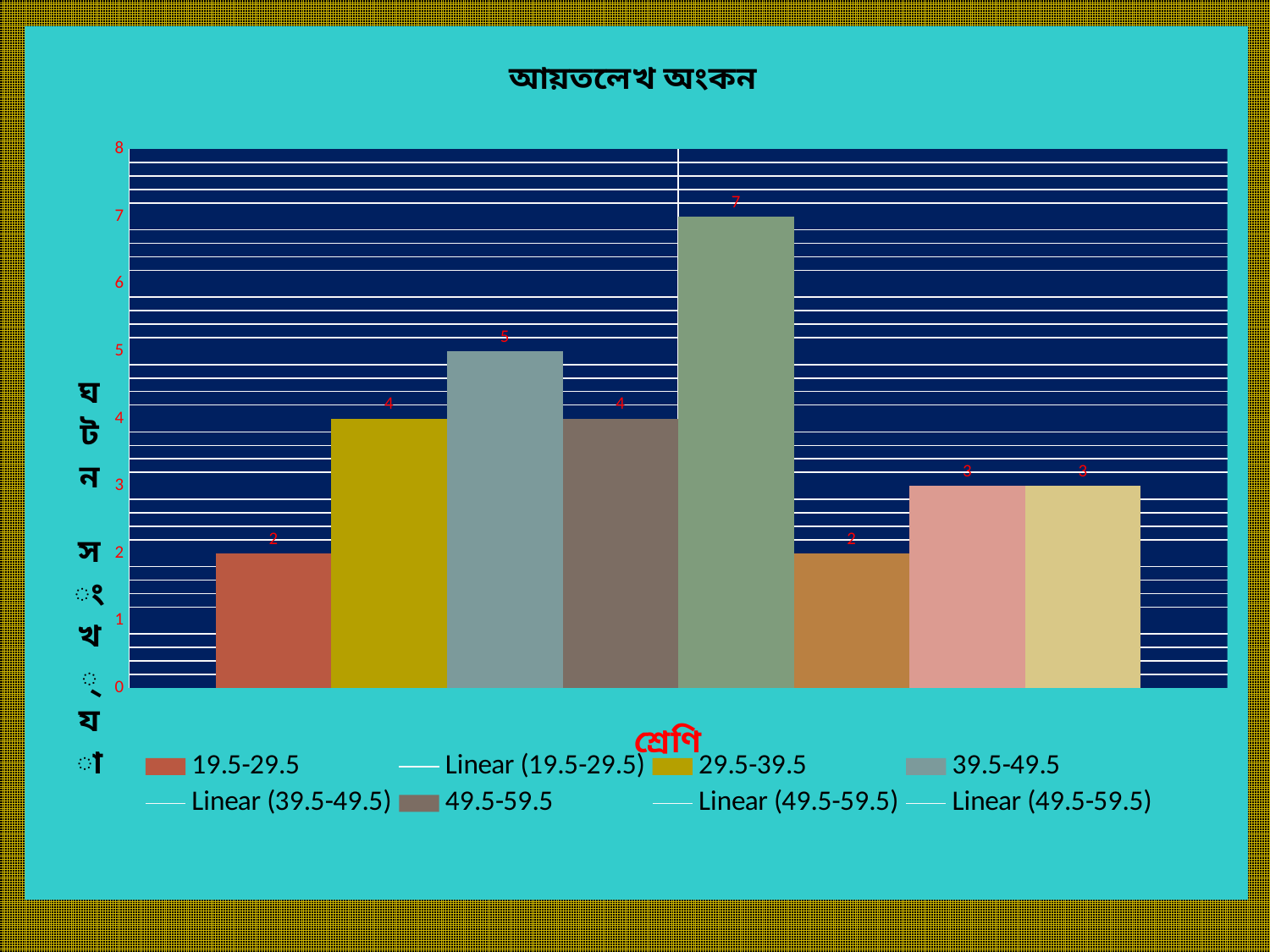
Which has the larger value, the 39.5-49.5 class or the 29.5-39.5 class? 39.5-49.5 What is the value of the bar for the 49.5-59.5 class? 4 What is the value of the bar for the 29.5-39.5 class? 4 What is the highest value labelled on any bar in the chart? 7 What is the value of the bar for the 39.5-49.5 class? 5 What is the highest tick value shown on the vertical axis? 8 What is the lowest value labelled on any bar in the chart? 2 What kind of chart is shown on the slide? Bar chart What is the title of the chart? আয়তলেখ অংকন What is the difference between the values for the 39.5-49.5 class and the 19.5-29.5 class? 3 What is the value of the bar for the 19.5-29.5 class? 2 How many bars are plotted in the chart? 8